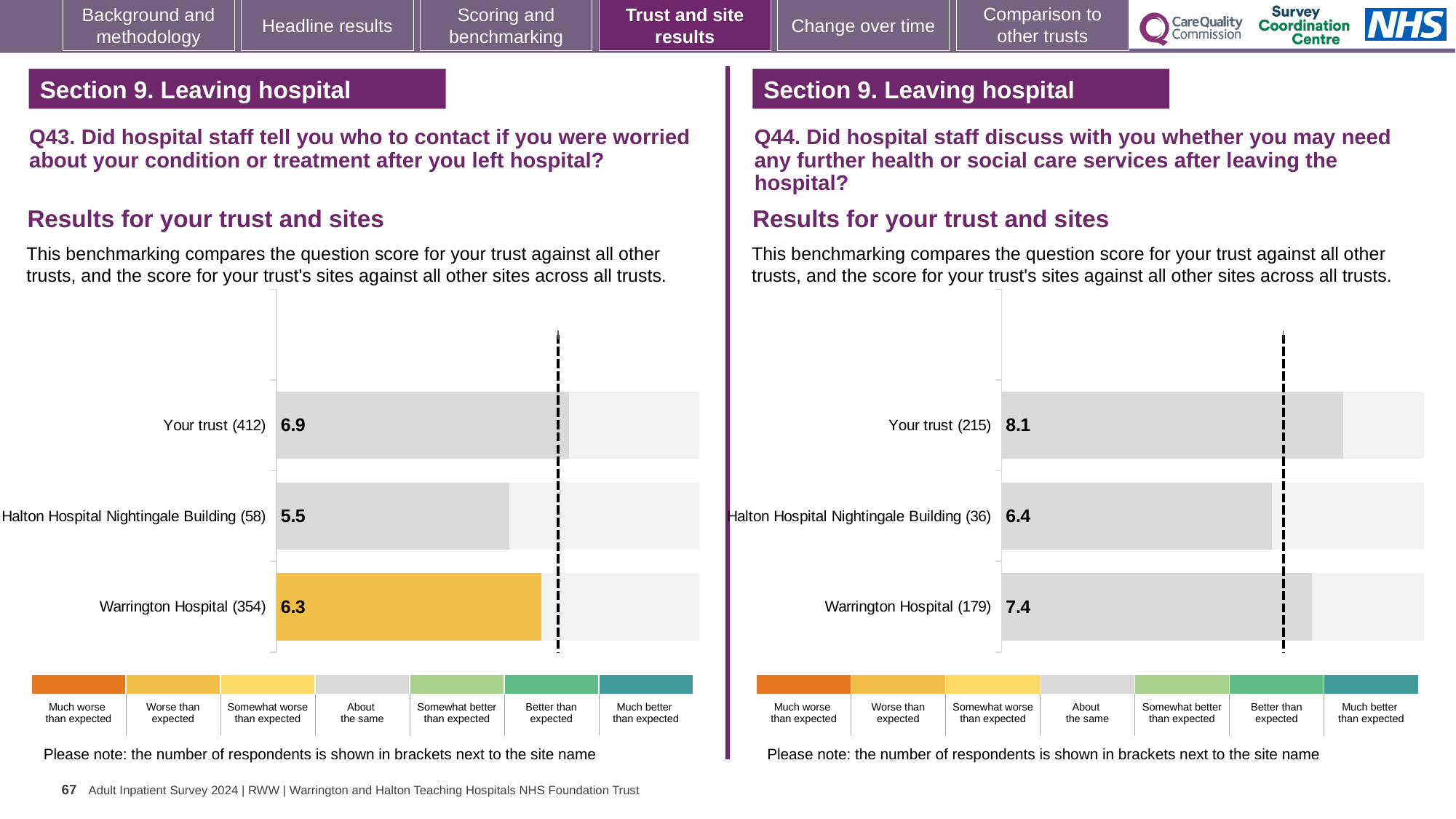
On the Q44 chart (right), which has the larger score, Warrington Hospital or Halton Hospital Nightingale Building? Warrington Hospital On the Q44 chart (right), what is the score for Your trust? 8.1 On the Q44 chart (right), what is the score for Warrington Hospital? 7.4 How many bars are shown on the Q44 chart (right)? 3 On the Q43 chart (left), how many respondents are shown in brackets for Warrington Hospital? 354 On the Q43 chart (left), what is the score for Your trust? 6.9 On the Q43 chart (left), what is the score for Halton Hospital Nightingale Building? 5.5 On the Q43 chart (left), which site or trust has the lowest score? Halton Hospital Nightingale Building On the Q44 chart (right), which site or trust has the highest score? Your trust On the Q44 chart (right), what is the score for Halton Hospital Nightingale Building? 6.4 On the Q43 chart (left), what is the score for Warrington Hospital? 6.3 On the Q43 chart (left), what is the difference between the scores for Your trust and Halton Hospital Nightingale Building? 1.4